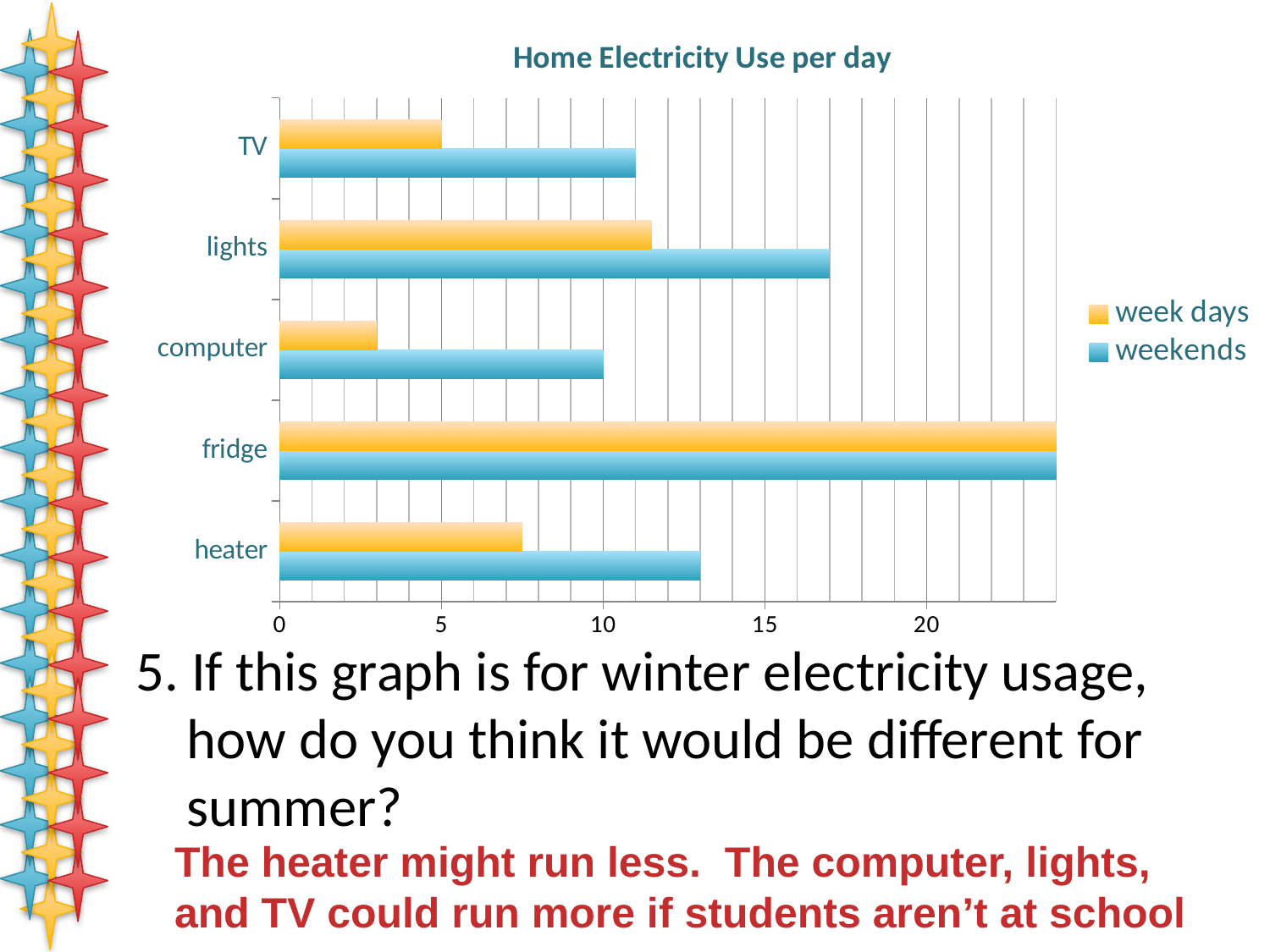
What kind of chart is shown on the slide? bar chart Is the week days value for computer greater or less than 5? less Is the weekends value for lights greater or less than 15? greater Which category has the highest weekends value? fridge Which is larger, the weekends value for lights or the weekends value for TV? lights Which colour represents the week days series in the legend? yellow Is the weekends value for heater greater or less than 10? greater Which category has the lowest week days value? computer How many series does the legend list? 2 What is the title of the chart? Home Electricity Use per day How many categories are shown on the chart? 5